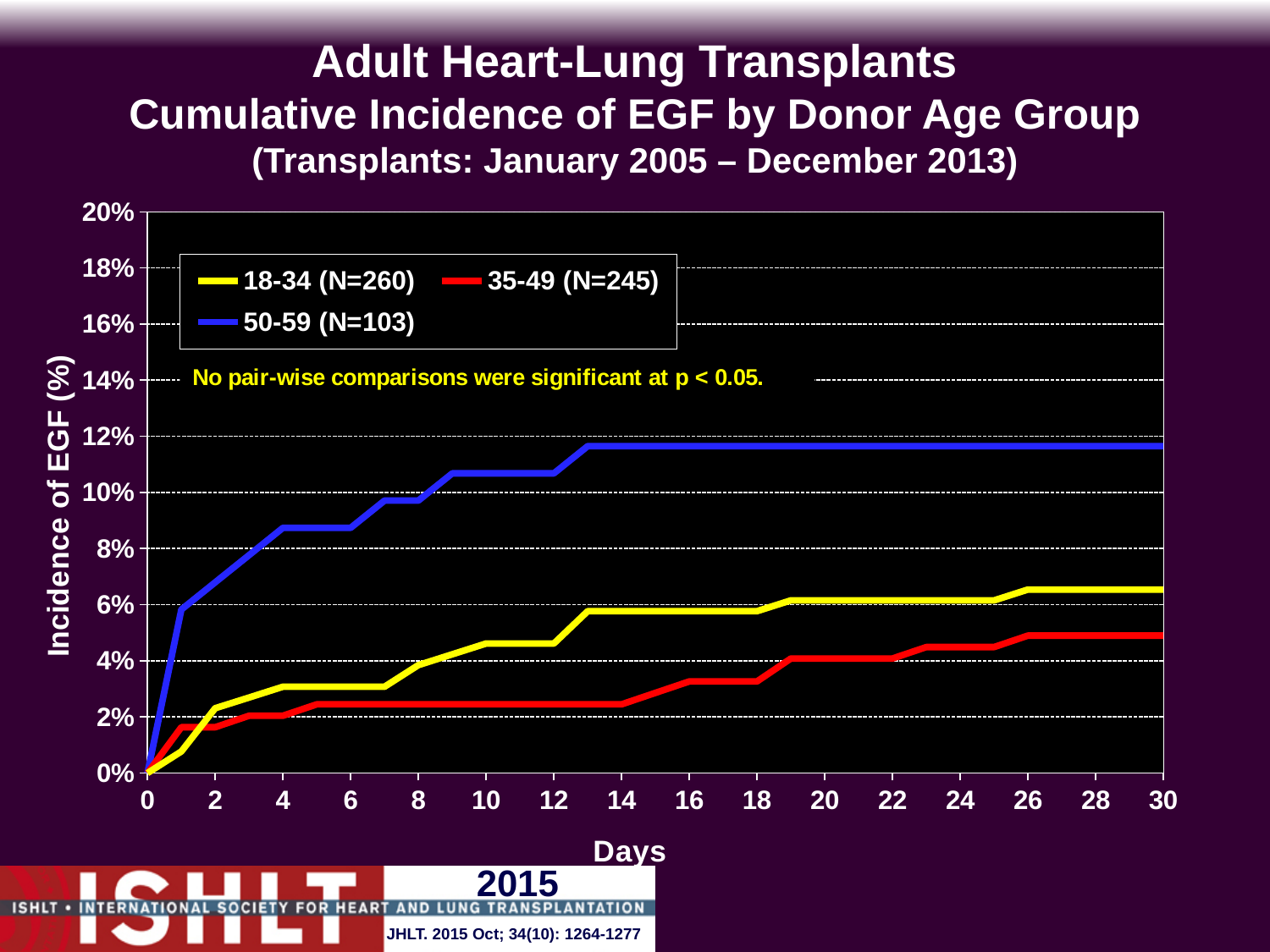
What is the N for the 18-34 donor age group shown in the legend? 260 Is the value for the 35-49 group at day 30 greater or less than 6%? less How many series does the legend list? 3 At day 30, which group has the larger cumulative incidence of EGF: 18-34 or 35-49? 18-34 What kind of chart is shown on the slide? Line chart Do the cumulative incidence values rise or fall as days increase? Rise What colour is the line for the 50-59 donor age group? Blue Which donor age group has the highest cumulative incidence of EGF at day 30? 50-59 (N=103) Is the value for the 50-59 group at day 4 greater or less than 6%? greater Which donor age group has the lowest cumulative incidence of EGF at day 30? 35-49 (N=245) Is the value for the 18-34 group at day 30 greater or less than 8%? less